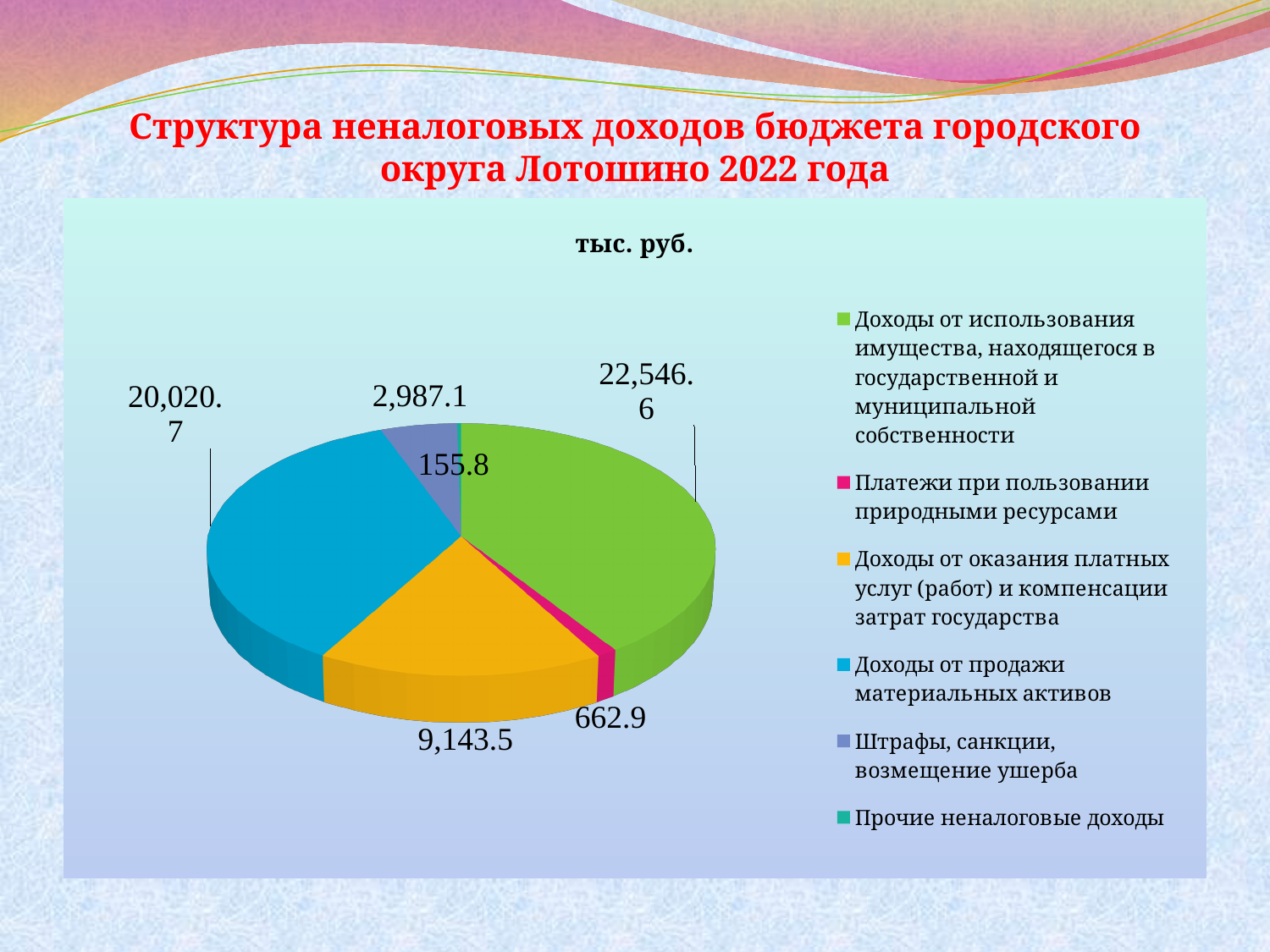
Which is larger: "Штрафы, санкции, возмещение ущерба" or "Платежи при пользовании природными ресурсами"? Штрафы, санкции, возмещение ущерба Which category has the largest value? Доходы от использования имущества, находящегося в государственной и муниципальной собственности What is the value for "Доходы от оказания платных услуг (работ) и компенсации затрат государства"? 9,143.5 What is the value for "Платежи при пользовании природными ресурсами"? 662.9 How many categories does the legend list? 6 What is the value for "Доходы от продажи материальных активов"? 20,020.7 What unit is given in the chart title? тыс. руб. What is the value for "Прочие неналоговые доходы"? 155.8 What is the value for "Доходы от использования имущества, находящегося в государственной и муниципальной собственности"? 22,546.6 What is the difference between the values for "Доходы от использования имущества" and "Доходы от продажи материальных активов"? 2,525.9 Which category has the smallest value? Прочие неналоговые доходы What type of chart is shown on the slide? pie chart